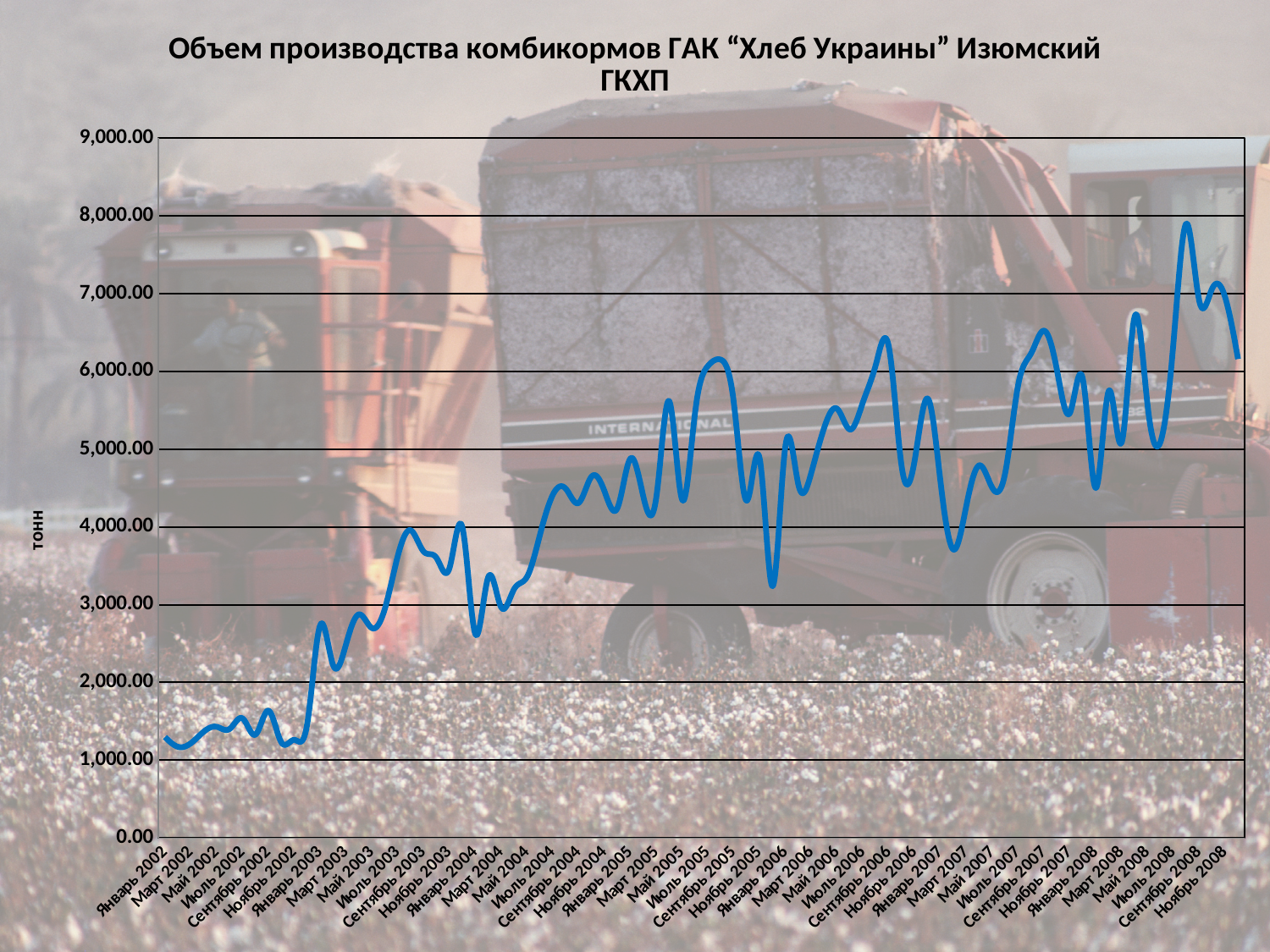
What is the title of the chart? Объем производства комбикормов ГАК "Хлеб Украины" Изюмский ГКХП Is the value for Ноябрь 2002 greater or less than 2,000.00? less Overall, do the values rise or fall from Январь 2002 to Ноябрь 2008? rise Is the value for Январь 2006 greater or less than 4,000.00? greater Which is larger, the value for Январь 2002 or the value for Ноябрь 2008? Ноябрь 2008 What is the highest value shown on the vertical axis? 9,000.00 Is the value for Май 2005 greater or less than 5,000.00? less What is the label on the vertical axis of the chart? тонн What kind of chart is shown on the slide? line chart